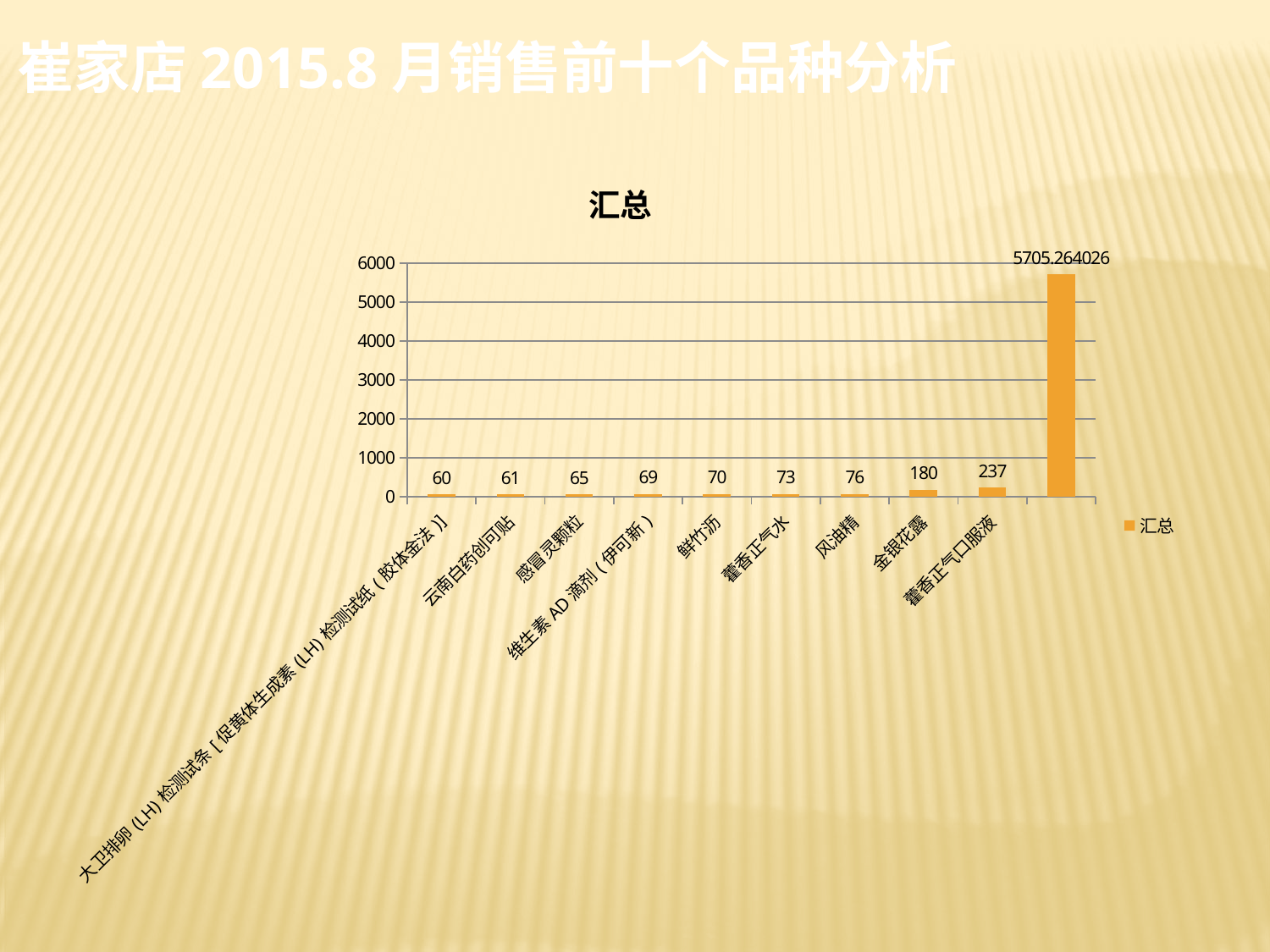
What is the value for 云南白药创可贴? 61 How many series does the legend list? 1 Which is larger, the value for 感冒灵颗粒 or the value for 藿香正气水? 藿香正气水 What is the difference between the values for 藿香正气口服液 and 金银花露? 57 What is the value for 鲜竹沥? 70 What is the highest value shown in the chart? 5705.264026 What is the value for 金银花露? 180 What is the value for 藿香正气口服液? 237 Which category has the lowest value? 大卫排卵(LH)检测试条[促黄体生成素(LH)检测试纸(胶体金法)] What is the value for 风油精? 76 How many categories are plotted in the chart? 10 What kind of chart is shown on the slide? bar chart